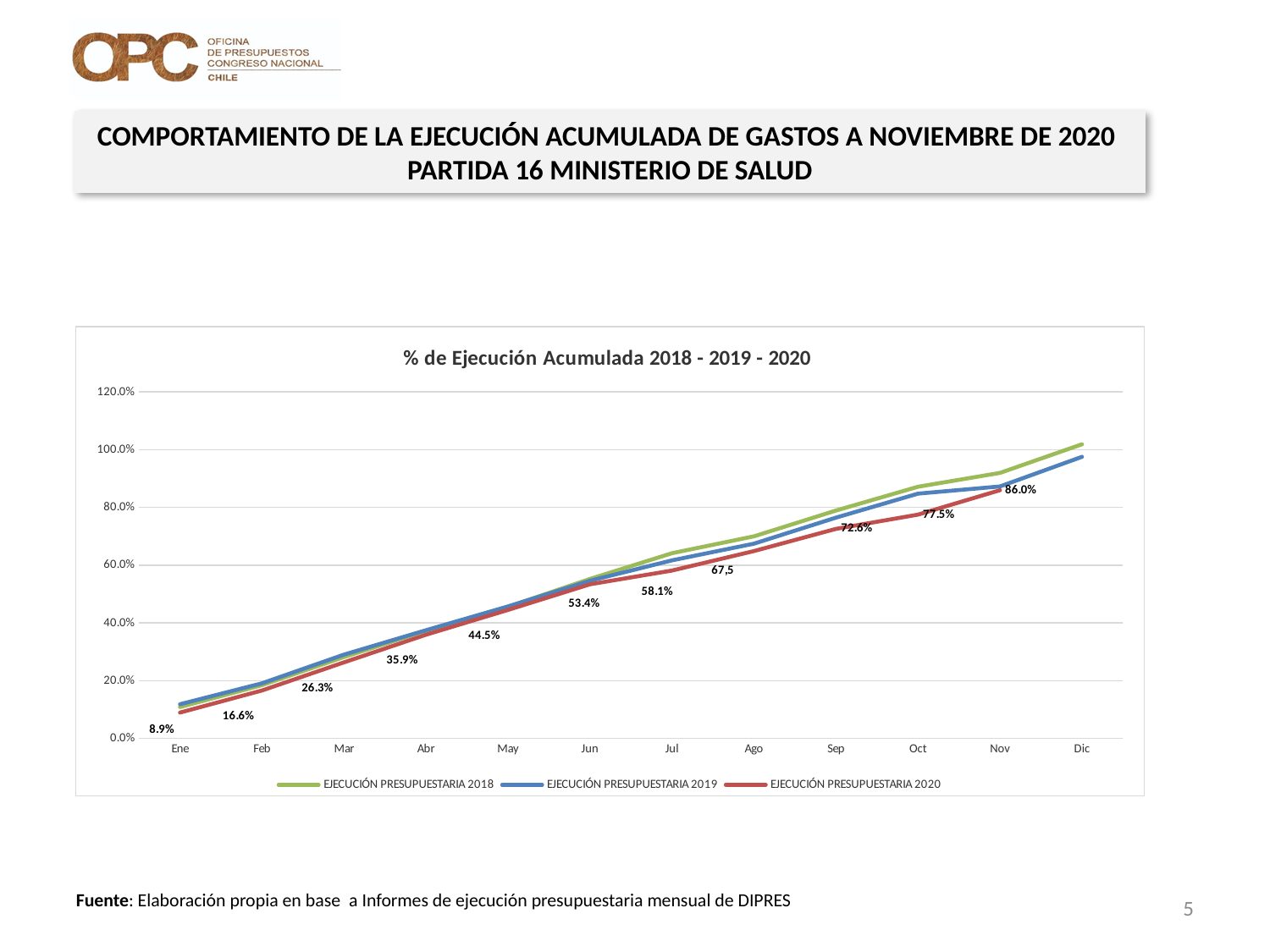
What is the value for EJECUCIÓN PRESUPUESTARIA 2020 in Nov? 86.0% What is the title of the chart? % de Ejecución Acumulada 2018 - 2019 - 2020 How many series does the legend list? 3 What type of chart is shown on the slide? line chart What is the difference between the EJECUCIÓN PRESUPUESTARIA 2020 values for Nov and Oct? 8.5% What is the value for EJECUCIÓN PRESUPUESTARIA 2020 in Sep? 72.6% Does the EJECUCIÓN PRESUPUESTARIA 2020 line rise or fall from Ene to Nov? rise What is the value for EJECUCIÓN PRESUPUESTARIA 2020 in Ene? 8.9% What is the value for EJECUCIÓN PRESUPUESTARIA 2020 in Jun? 53.4% Which series has the higher value in Oct, EJECUCIÓN PRESUPUESTARIA 2018 or EJECUCIÓN PRESUPUESTARIA 2020? EJECUCIÓN PRESUPUESTARIA 2018 How many months are shown on the x axis? 12